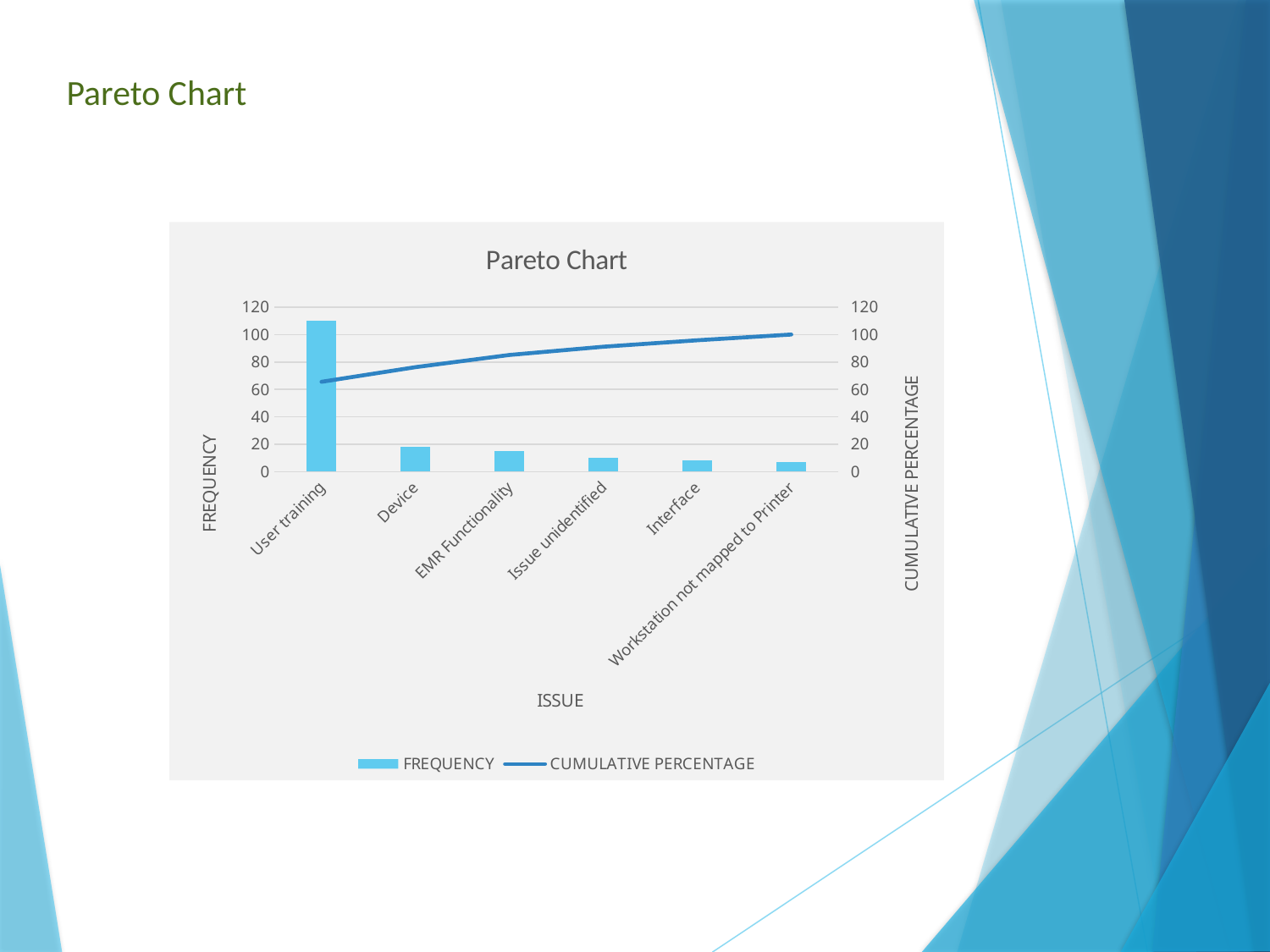
Which issue has the highest frequency? User training What is the label of the right-hand vertical axis? CUMULATIVE PERCENTAGE Is the frequency for User training greater or less than 100? greater Is the frequency for Device greater or less than 40? less How many series does the legend list? 2 How many issue categories are shown on the x axis? 6 Which has a higher frequency, Device or Issue unidentified? Device Do the frequency bars rise or fall from left to right along the x axis? fall What kind of chart is shown on the slide? A combined bar and line chart Which has a higher frequency, User training or Device? User training Is the cumulative percentage for User training greater or less than 60? greater Does the cumulative percentage line rise or fall from left to right? rise